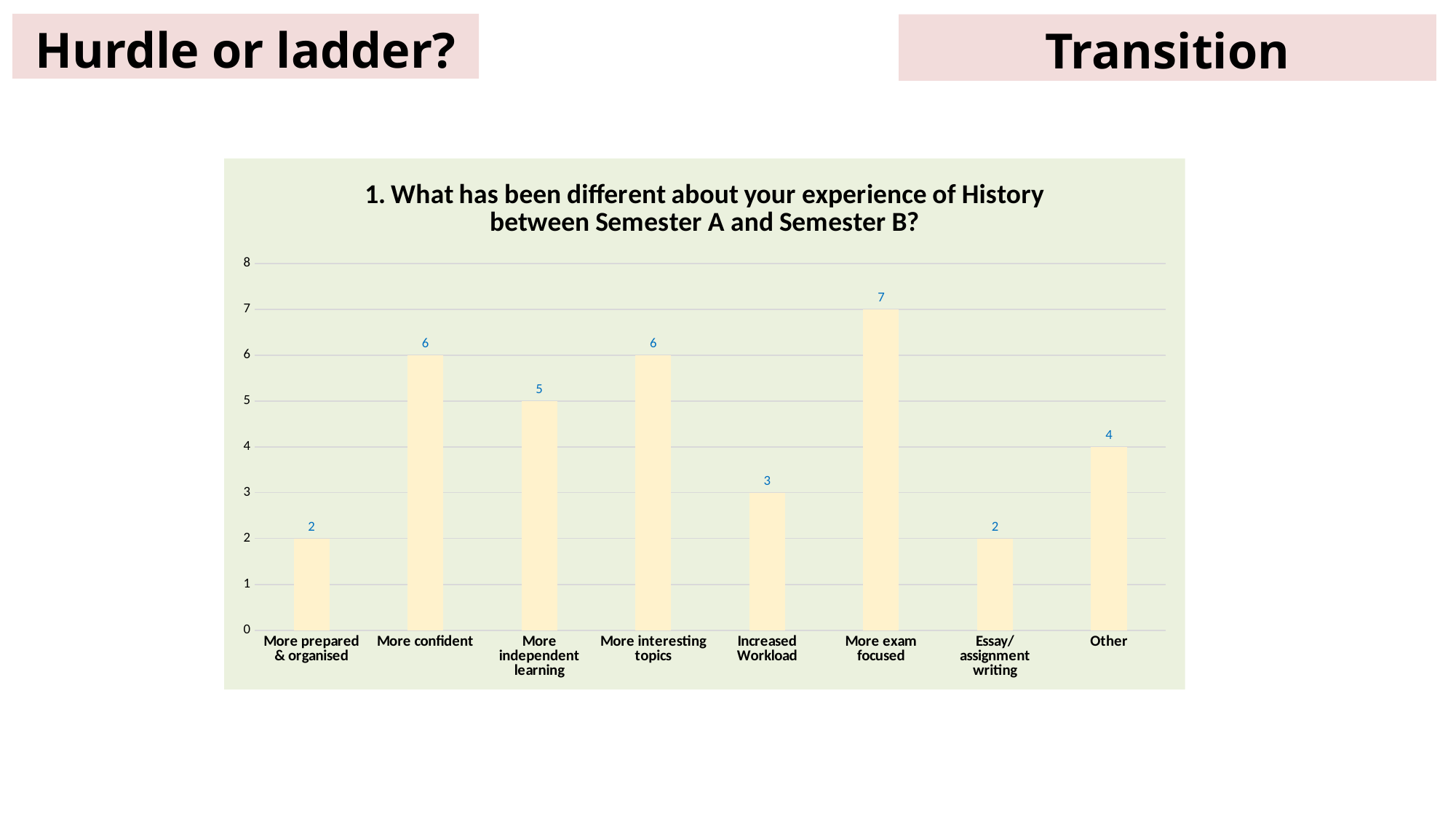
Is the value for More interesting topics greater or less than 5? greater Which category has the highest value? More exam focused What kind of chart is shown on the slide? bar chart What is the difference between the values for More exam focused and Increased Workload? 4 What is the title of the chart? 1. What has been different about your experience of History between Semester A and Semester B? What is the value for Increased Workload? 3 What is the value for Other? 4 How many categories are shown on the x axis? 8 What is the highest value shown on the y axis? 8 Which is larger, the value for More confident or the value for Other? More confident What is the value for More exam focused? 7 What is the value for More independent learning? 5